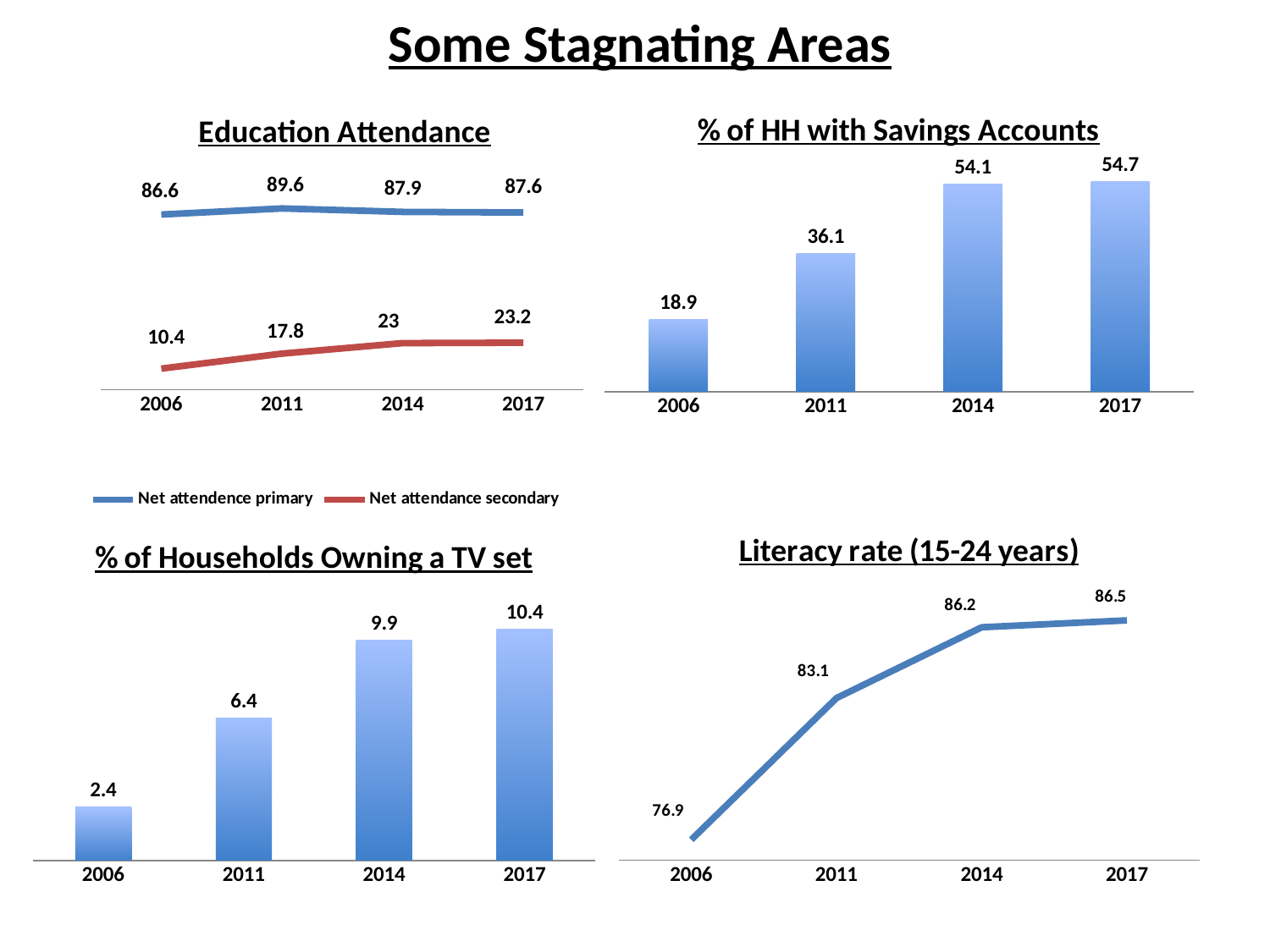
In the 'Literacy rate (15-24 years)' chart, how many data points are plotted? 4 In the 'Education Attendance' chart, what is the value for Net attendance secondary in 2014? 23 In the '% of Households Owning a TV set' chart, what is the difference between the 2014 and 2011 values? 3.5 In the 'Education Attendance' chart, which year has the highest value for Net attendence primary? 2011 In the '% of Households Owning a TV set' chart, what is the value for 2017? 10.4 In the '% of HH with Savings Accounts' chart, what is the value for 2011? 36.1 In the 'Education Attendance' chart, what is the difference between Net attendence primary and Net attendance secondary in 2006? 76.2 In the 'Education Attendance' chart, how many series does the legend list? 2 What kind of chart is '% of HH with Savings Accounts'? bar chart In the '% of HH with Savings Accounts' chart, which year has the lowest value? 2006 In the 'Literacy rate (15-24 years)' chart, what is the value for 2006? 76.9 In the '% of Households Owning a TV set' chart, do the values rise or fall from 2006 to 2017? rise